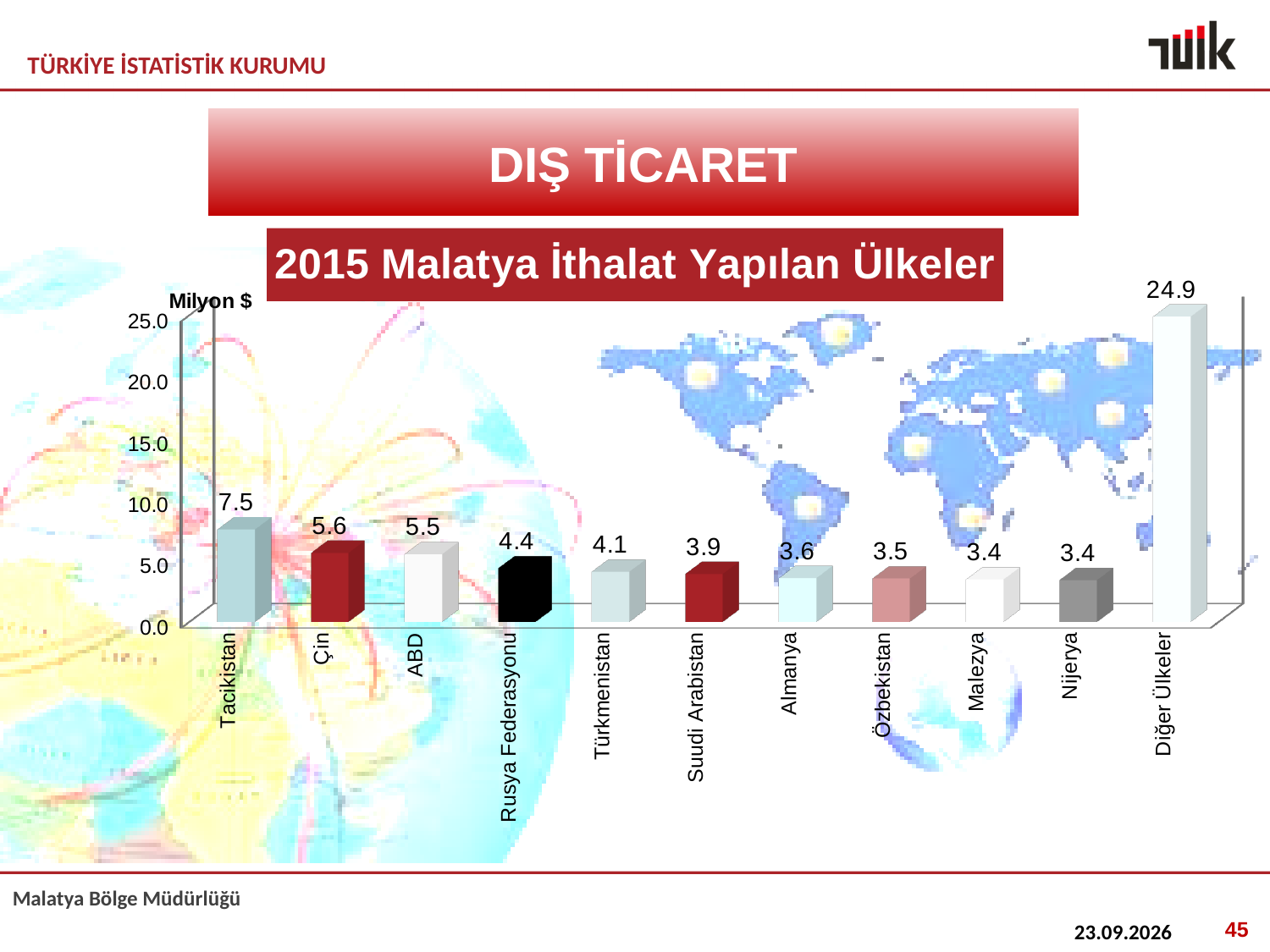
Is the value for Diğer Ülkeler greater or less than 20.0? greater Which individual country has the highest value? Tacikistan What is the value for Rusya Federasyonu? 4.4 What unit is shown on the chart's axis label? Milyon $ Which is larger, the value for Çin or the value for ABD? Çin What is the difference between the values for Tacikistan and Çin? 1.9 What is the value for Diğer Ülkeler? 24.9 What is the lowest value shown on the chart? 3.4 What is the value for Tacikistan? 7.5 How many categories are shown on the chart? 11 Which category has the highest value? Diğer Ülkeler What is the value for Özbekistan? 3.5